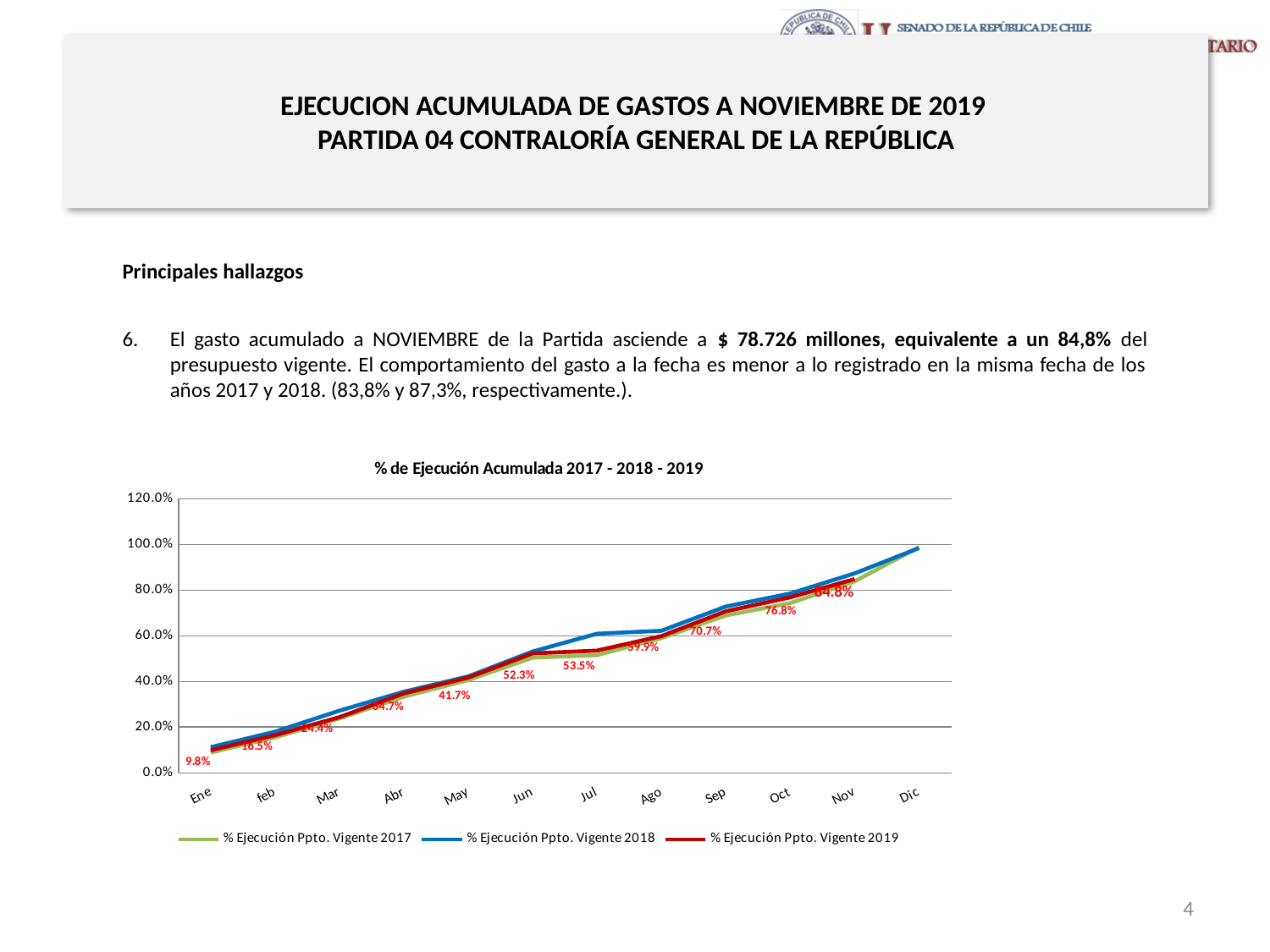
How many series does the chart legend list? 3 What is the difference between the 2019 values for Oct and Sep? 6.1% What is the value of % Ejecución Ppto. Vigente 2019 for Ene? 9.8% What is the value of % Ejecución Ppto. Vigente 2019 for Sep? 70.7% Do the values of the 2019 series rise or fall from Ene to Nov? rise Is the value of % Ejecución Ppto. Vigente 2018 for Dic greater or less than 80%? greater What is the value of % Ejecución Ppto. Vigente 2019 for Nov? 84.8% What kind of chart is shown on the slide? line chart Which is larger for the 2019 series, the value for Jun or the value for Jul? Jul How many months are shown along the x axis of the chart? 12 What is the value of % Ejecución Ppto. Vigente 2019 for Feb? 16.5% What is the title of the chart? % de Ejecución Acumulada 2017 - 2018 - 2019